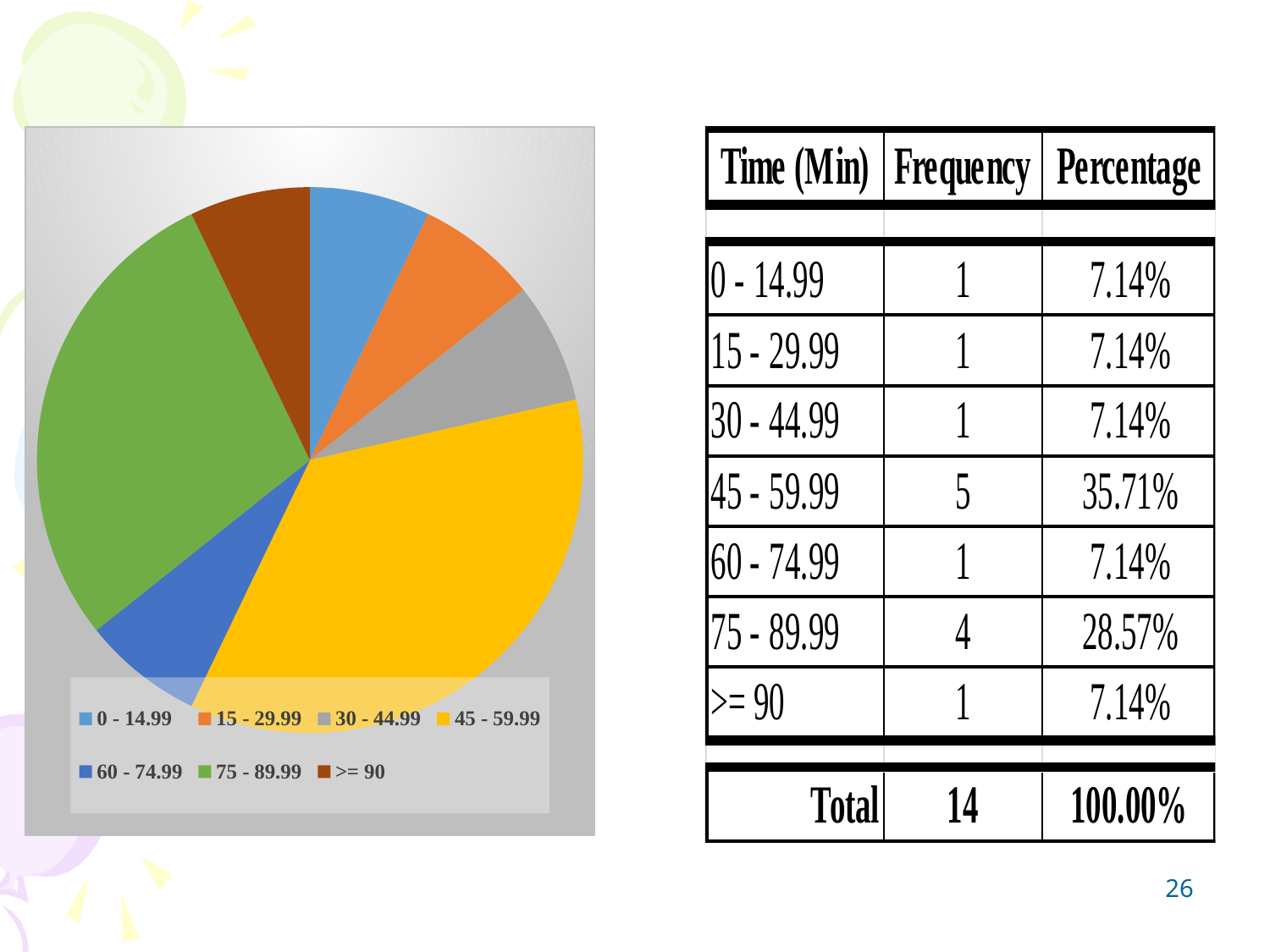
Which time category has the largest slice in the pie chart? 45 - 59.99 According to the table, what percentage share does the 45 - 59.99 category have? 35.71% What is the frequency for the 75 - 89.99 time category in the table? 4 Which slice is larger in the pie chart, 75 - 89.99 or 60 - 74.99? 75 - 89.99 What is the total frequency shown in the table? 14 What is the frequency for the >= 90 time category in the table? 1 What kind of chart is shown on the left of the slide? pie chart How many categories (slices) does the pie chart have? 7 What is the difference in frequency between the 45 - 59.99 and 75 - 89.99 categories? 1 According to the table, what percentage share does the 75 - 89.99 category have? 28.57% What colour is the 45 - 59.99 slice in the pie chart? yellow Which slice is larger in the pie chart, 45 - 59.99 or 75 - 89.99? 45 - 59.99